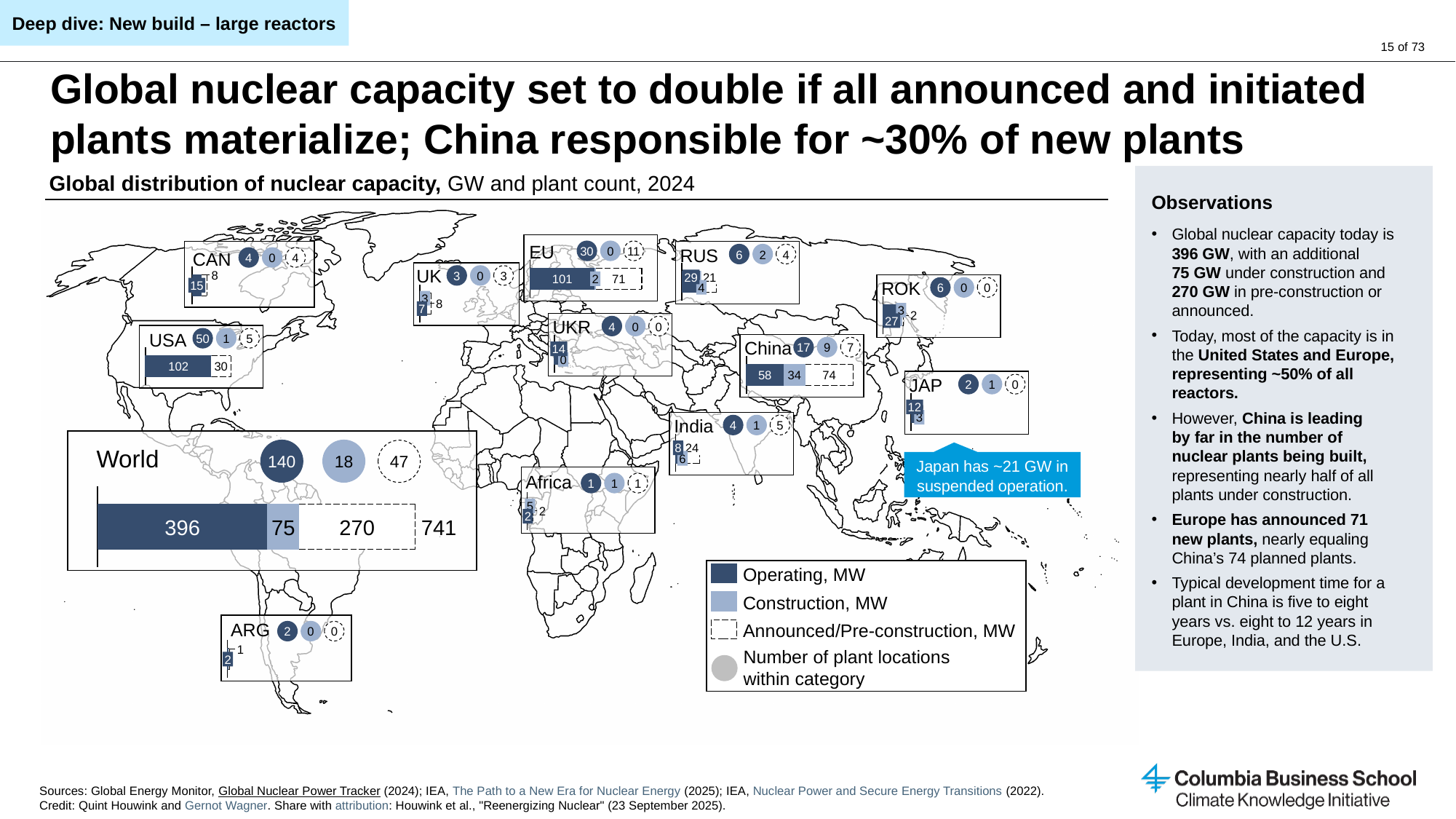
What is the announced/pre-construction value shown for China? 74 What is the difference between the World's announced/pre-construction value (270) and its construction value (75)? 195 What is the operating nuclear capacity shown for the World bar? 396 What is the difference between China's announced/pre-construction value (74) and the EU's (71)? 3 How many plant locations are shown in the operating category for the World? 140 What is the operating capacity value shown for the USA? 102 What kind of chart is used to show the capacity values for each region? Stacked bar chart What is the announced/pre-construction value shown for the EU? 71 Which region has the highest construction value among the regional bars? China What is the total shown at the end of the World stacked bar? 741 How many entries does the legend list? 4